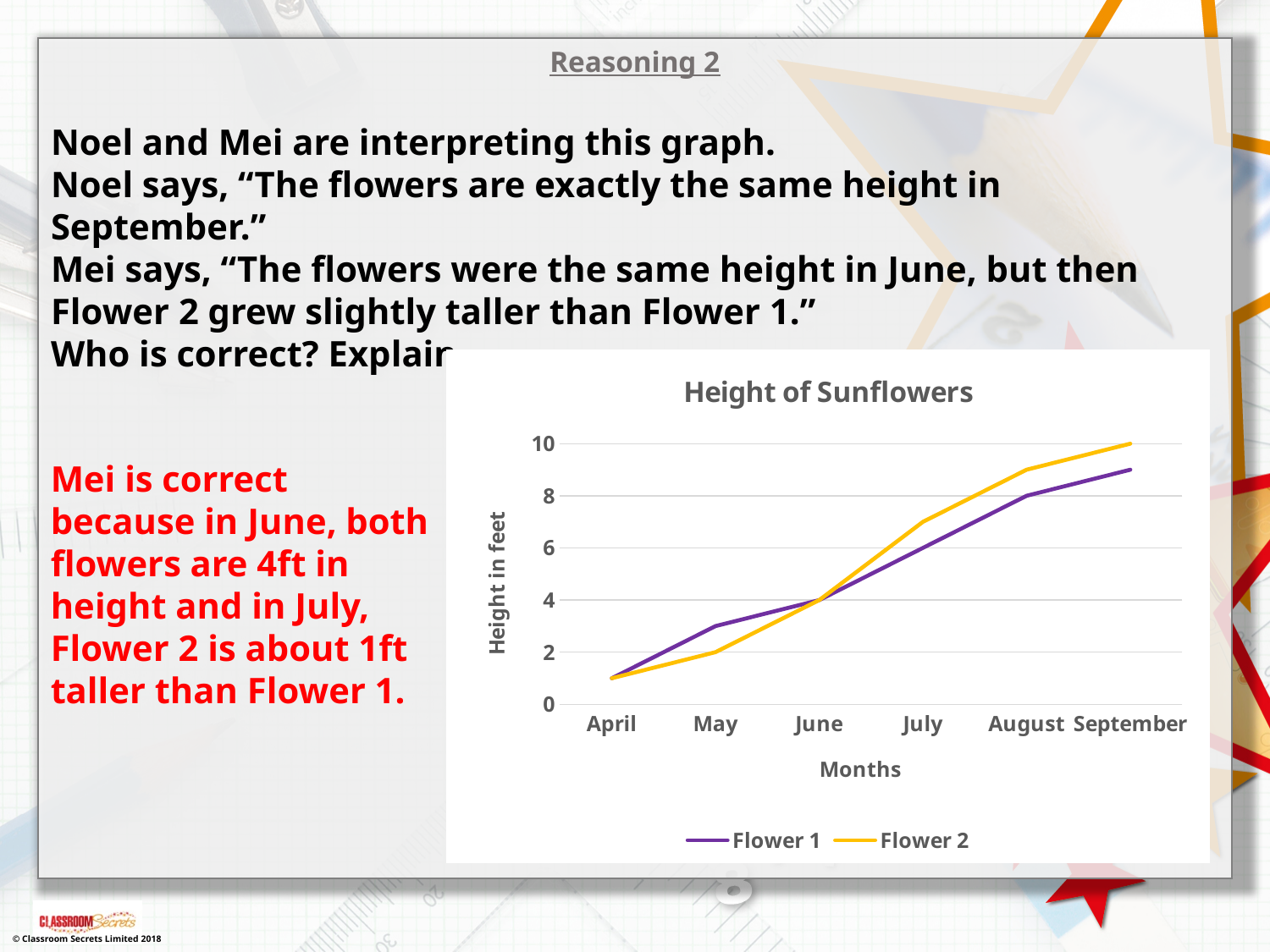
Which flower is taller in May, Flower 1 or Flower 2? Flower 1 Is the height of Flower 2 in July greater or less than 6? greater Which flower is taller in September, Flower 1 or Flower 2? Flower 2 What is the height of Flower 2 in September? 10 What is the title of the chart? Height of Sunflowers Do the heights of the flowers rise or fall from April to September? Rise What is the height of Flower 1 in August? 8 What type of chart is shown on the slide? Line chart How many months are shown on the x axis of the chart? 6 Is the height of Flower 1 in September greater or less than 8? greater What is the height of Flower 1 in June? 4 How many series does the chart's legend list? 2